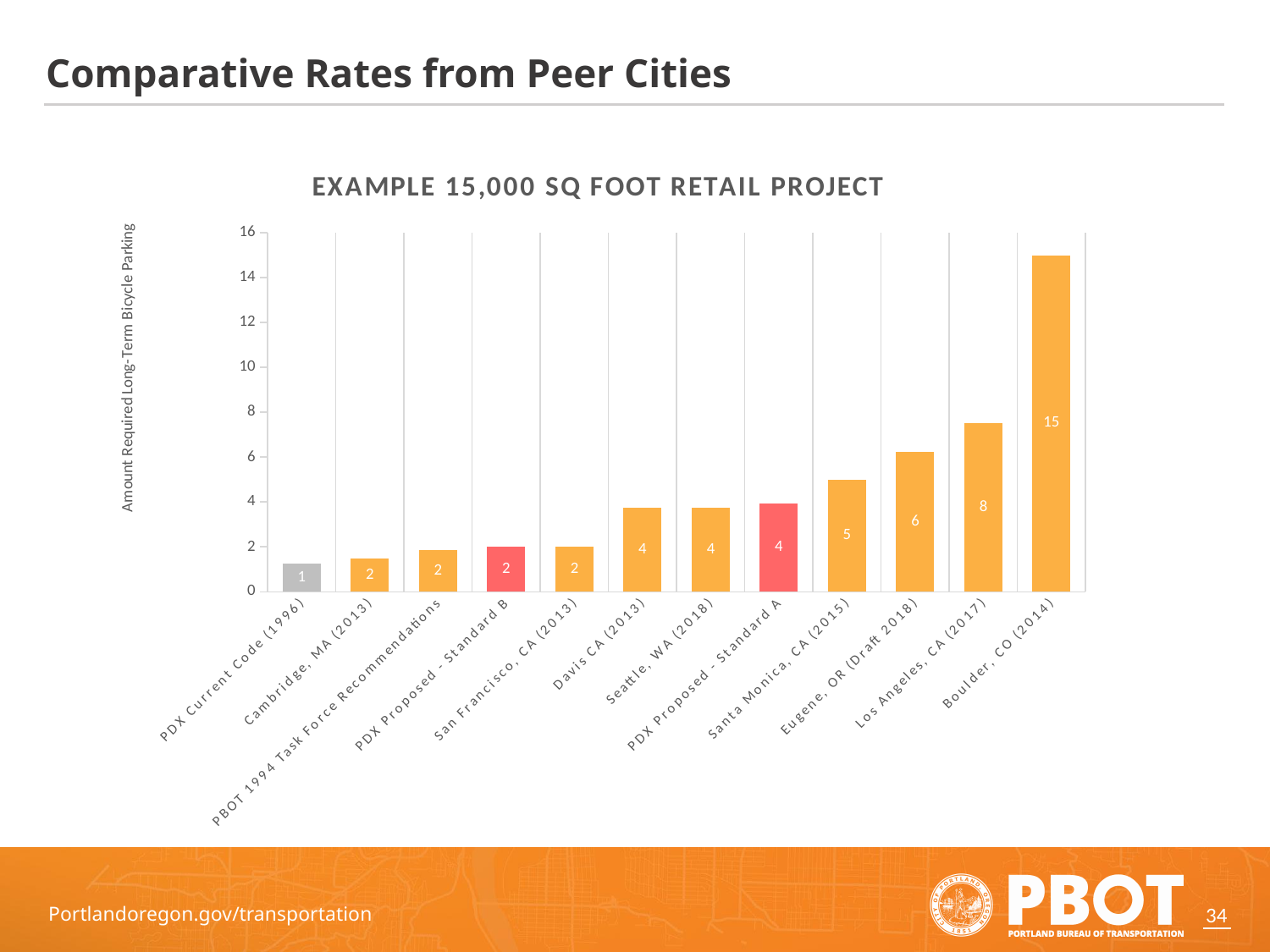
What is the title of the chart? EXAMPLE 15,000 SQ FOOT RETAIL PROJECT What is the value for PDX Current Code (1996)? 1 Is the value for Boulder, CO (2014) greater or less than 10? greater How many categories are shown on the x axis? 12 What is the difference between the values for Boulder, CO (2014) and Los Angeles, CA (2017)? 7 Which is larger, the value for Eugene, OR (Draft 2018) or Santa Monica, CA (2015)? Eugene, OR (Draft 2018) Which category has the highest value? Boulder, CO (2014) What is the value for Boulder, CO (2014)? 15 What is the value for Eugene, OR (Draft 2018)? 6 What is the value for Los Angeles, CA (2017)? 8 Which category has the lowest value? PDX Current Code (1996) What kind of chart is shown on the slide? Bar chart